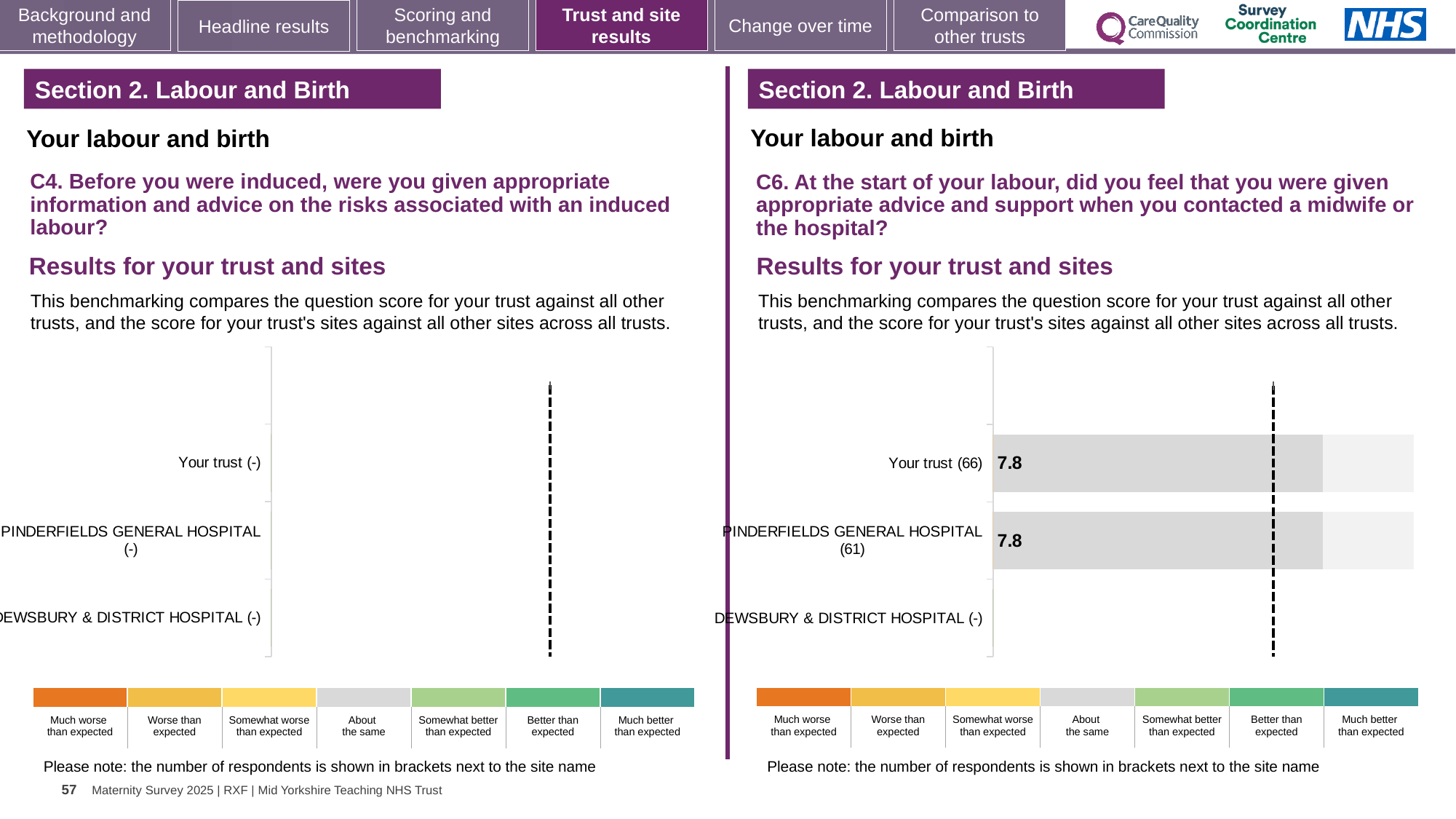
In the right-hand chart (C6), which category has no score bar plotted? DEWSBURY & DISTRICT HOSPITAL In the right-hand chart (C6), how many respondents are shown in brackets for Your trust? 66 How many colour categories does the key below each chart show, from 'Much worse than expected' to 'Much better than expected'? 7 What kind of chart is the right-hand chart (C6)? Bar chart In the right-hand chart (C6), how many site/trust categories are listed on the vertical axis? 3 In the left-hand chart (C4), how many site/trust categories are listed on the vertical axis? 3 In the right-hand chart (C6), what is the score for PINDERFIELDS GENERAL HOSPITAL? 7.8 In the right-hand chart (C6), what is the difference between the score for Your trust and the score for PINDERFIELDS GENERAL HOSPITAL? 0.0 In the right-hand chart (C6), what is the score for Your trust? 7.8 In the right-hand chart (C6), how many respondents are shown in brackets for PINDERFIELDS GENERAL HOSPITAL? 61